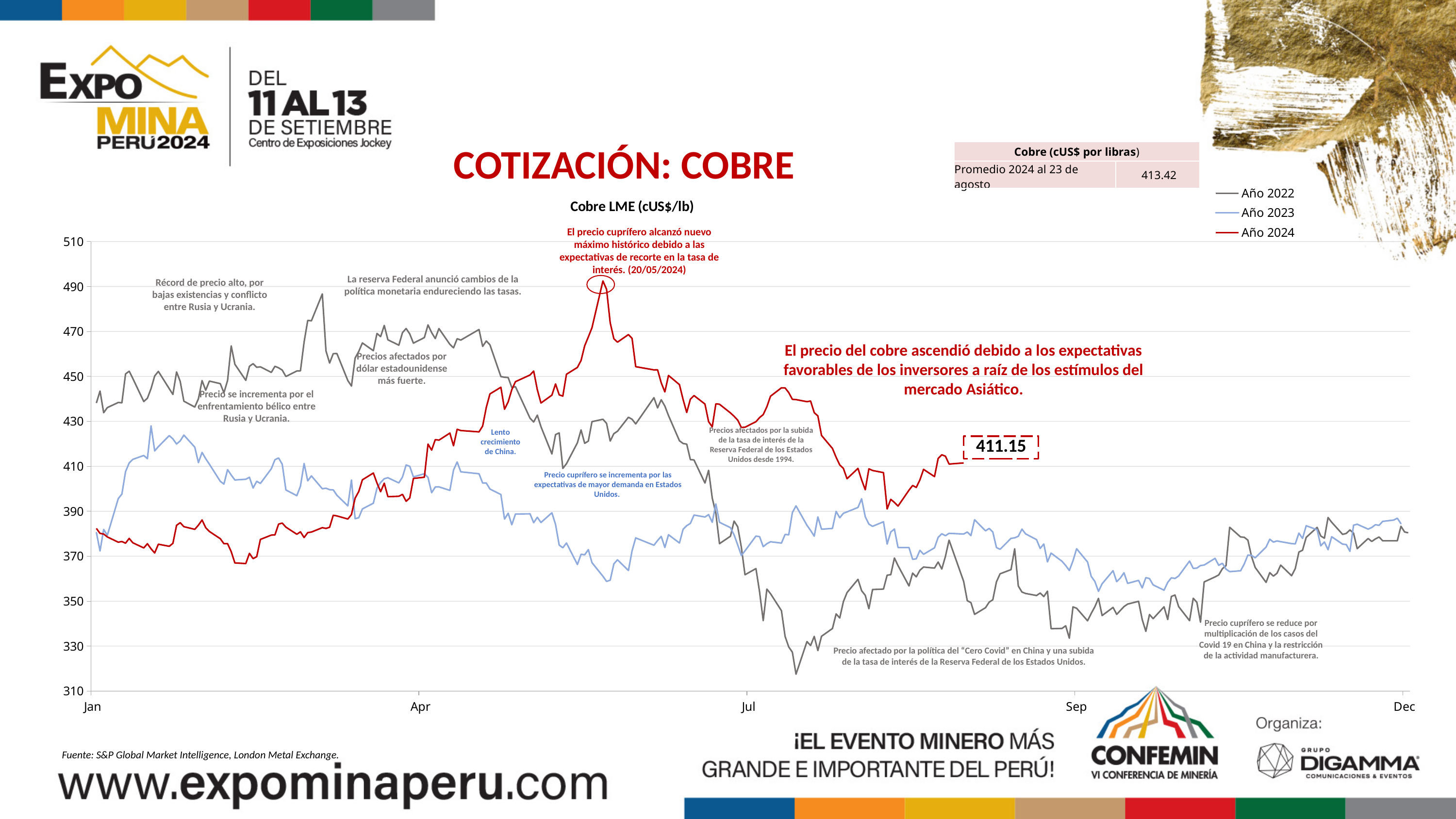
Is the lowest point of the Año 2023 line (around May–June) greater or less than 370? less How many series does the legend of the chart list? 3 Is the highest point of the Año 2022 line in the first quarter greater or less than 470? greater At the start of January, which line is higher: Año 2022 or Año 2024? Año 2022 What is the value printed at the end of the Año 2024 line? 411.15 Is the lowest point of the Año 2022 line (around July–August) greater or less than 330? less According to the table on the slide, what is the 'Promedio 2024 al 23 de agosto' for copper? 413.42 What is the title of the chart? Cobre LME (cUS$/lb) Which series is drawn in red in the chart? Año 2024 What kind of chart is shown on the slide? line chart Which series reaches the lowest value on the chart? Año 2022